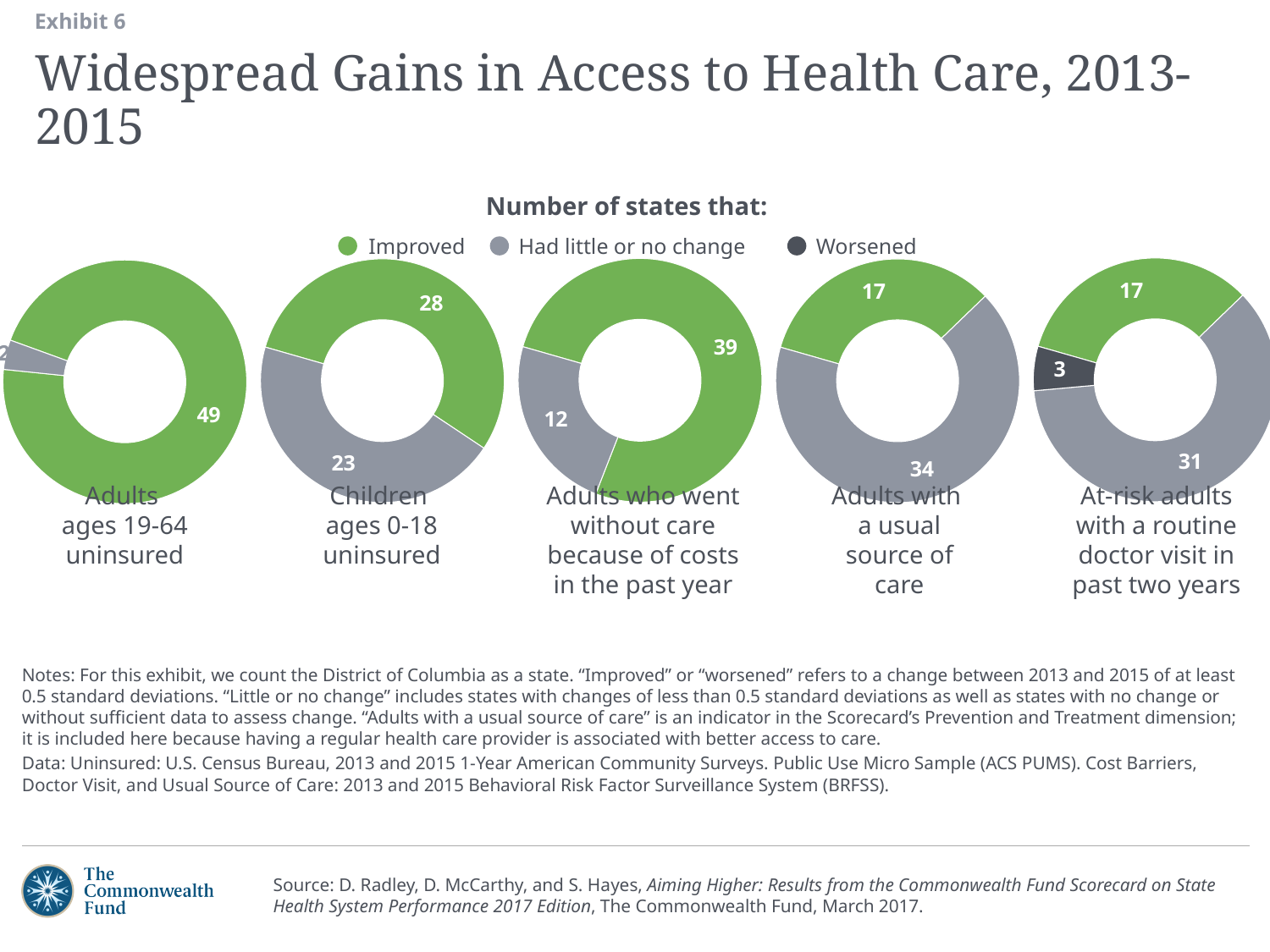
In the 'At-risk adults with a routine doctor visit in past two years' chart, what is the total number of states across all three segments? 51 What kind of chart is used on this slide? Donut (pie) chart In the 'Adults ages 19-64 uninsured' chart, how many states improved? 49 How many series does the legend list? 3 In the 'Adults with a usual source of care' chart, how many states had little or no change? 34 In the 'At-risk adults with a routine doctor visit in past two years' chart, how many states worsened? 3 In the 'Children ages 0-18 uninsured' chart, how many states had little or no change? 23 In the 'Children ages 0-18 uninsured' chart, how many states improved? 28 In the 'Adults with a usual source of care' chart, which is larger: the number of states that improved or the number that had little or no change? Had little or no change In the 'Adults who went without care because of costs in the past year' chart, how many states improved? 39 In the 'Adults who went without care because of costs in the past year' chart, what is the difference between the number of states that improved and the number that had little or no change? 27 How many donut charts are shown on the slide? 5